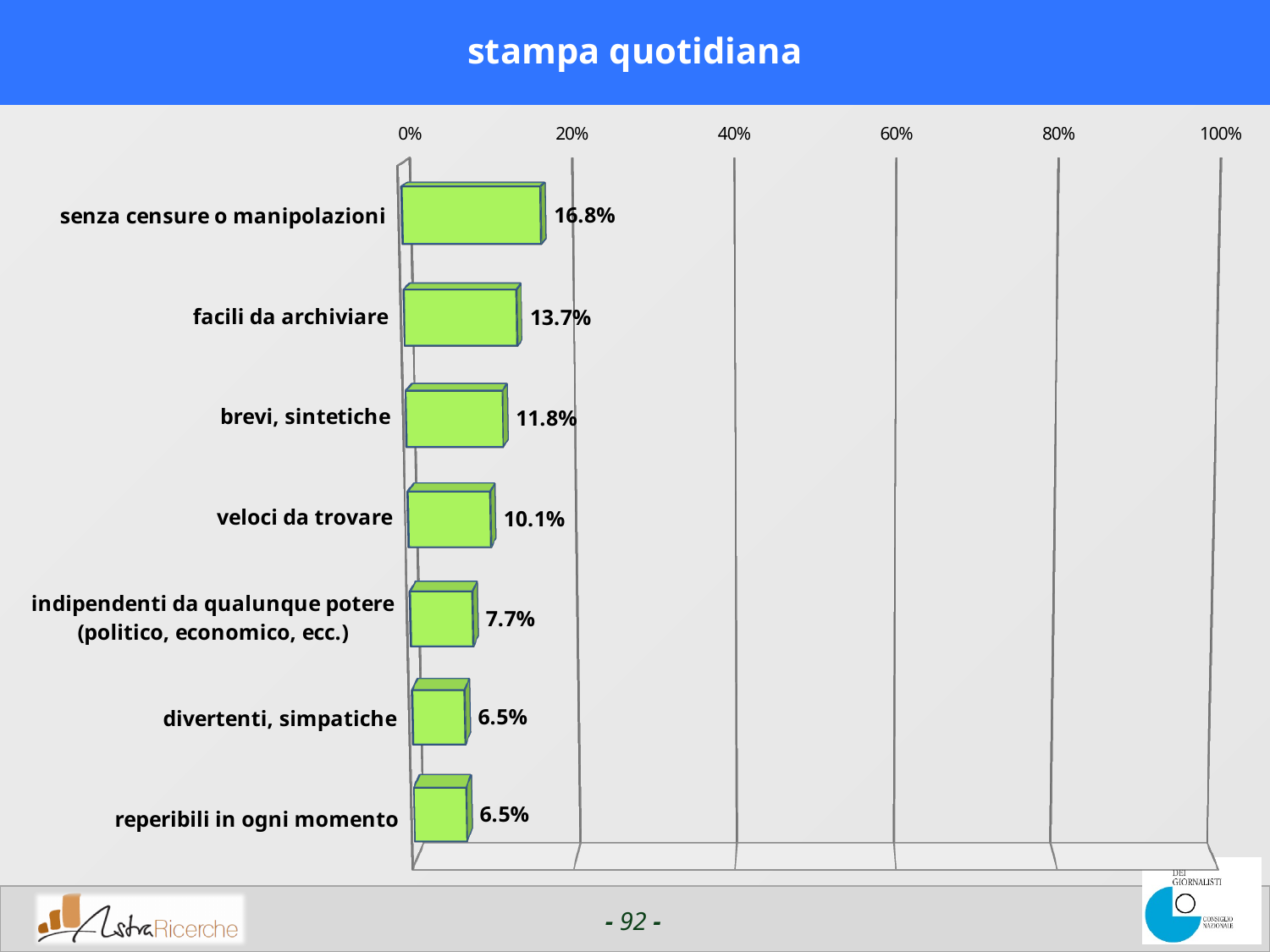
What is the value for "indipendenti da qualunque potere (politico, economico, ecc.)"? 7.7% What is the difference between the values for "senza censure o manipolazioni" and "facili da archiviare"? 3.1% Which is larger, the value for "brevi, sintetiche" or the value for "veloci da trovare"? brevi, sintetiche How many categories are shown in the chart? 7 What is the value for "senza censure o manipolazioni"? 16.8% Is the value for "senza censure o manipolazioni" greater or less than 20%? less What kind of chart is shown on the slide? bar chart What is the difference between the values for "brevi, sintetiche" and "divertenti, simpatiche"? 5.3% What is the value for "veloci da trovare"? 10.1% Which category has the highest value? senza censure o manipolazioni What is the title of the slide? stampa quotidiana What is the value for "facili da archiviare"? 13.7%